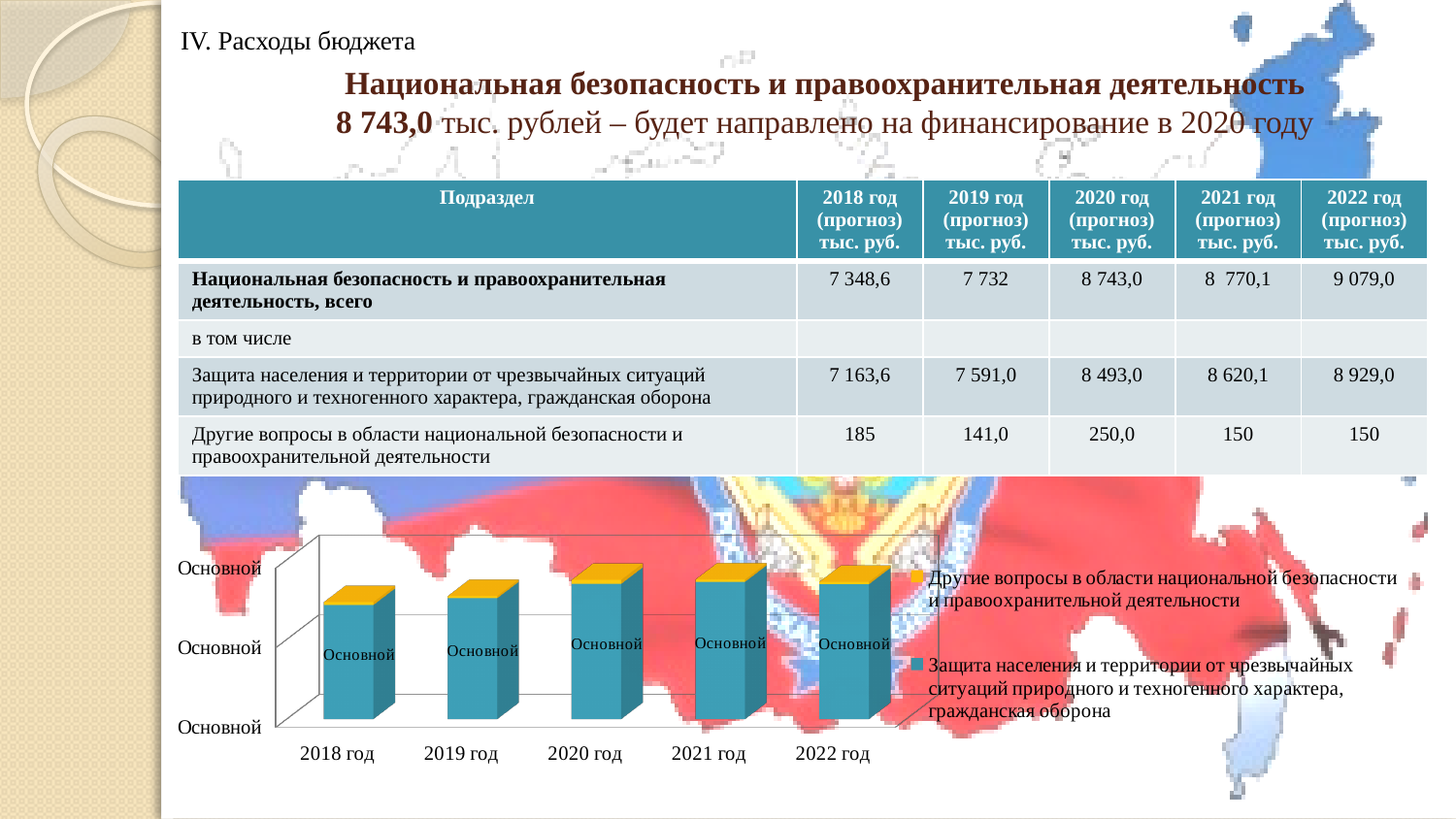
Do the bar heights rise or fall from 2018 год to 2022 год? rise How many series does the chart legend list? 2 What kind of chart is shown at the bottom of the slide? bar chart Which legend entry is shown in yellow in the chart? Другие вопросы в области национальной безопасности и правоохранительной деятельности What is the first category label on the x axis of the chart? 2018 год Which year has the shortest bar in the chart? 2018 год How many categories (years) are shown on the x axis of the chart? 5 Is the bar for 2022 год taller or shorter than the bar for 2018 год? taller